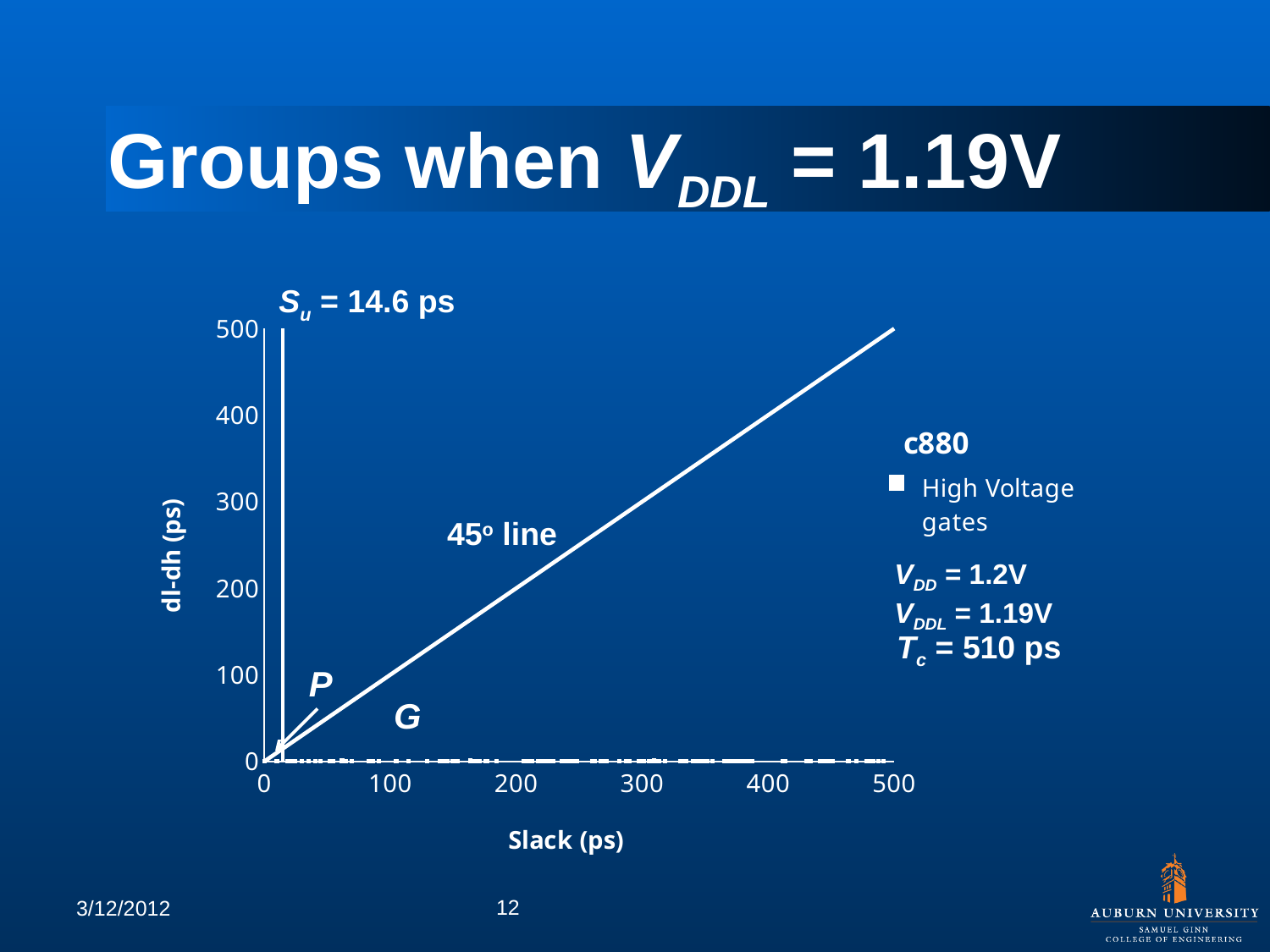
What value of V_DD is annotated on the chart? 1.2V What value of S_u is annotated on the chart? 14.6 ps What is the title shown above the chart legend? c880 What value of V_DDL is annotated on the chart? 1.19V How many series does the chart legend list? 1 What value of T_c is annotated on the chart? 510 ps Are the dl-dh values of the plotted High Voltage gates greater or less than 100 ps? less Is the largest Slack value shown on the x axis greater or less than 400? greater What kind of chart is shown on the slide? scatter chart What is the name of the series listed in the chart legend? High Voltage gates